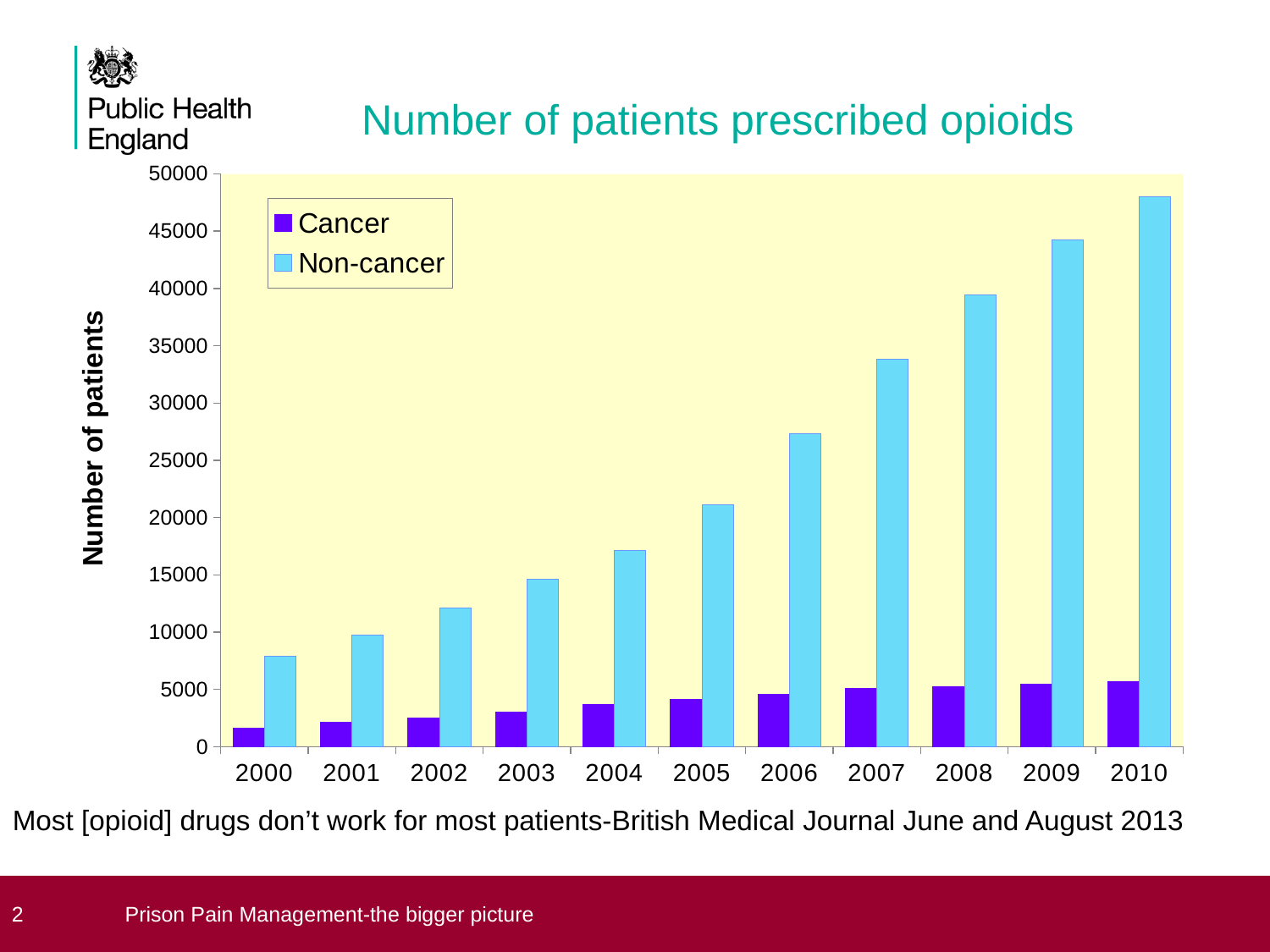
How many series does the legend list? 2 How many years are shown on the x axis? 11 Which year has the lowest Cancer value? 2000 Is the Non-cancer value for 2007 greater or less than 30000? greater Do the Non-cancer values rise or fall from 2000 to 2010? rise Which year has the highest Non-cancer value? 2010 Is the Cancer value for 2010 greater or less than 10000? less Is the Non-cancer value for 2010 greater or less than 45000? greater What kind of chart is shown on the slide? bar chart Which is larger in 2005, the Cancer value or the Non-cancer value? Non-cancer What is the title of the chart? Number of patients prescribed opioids